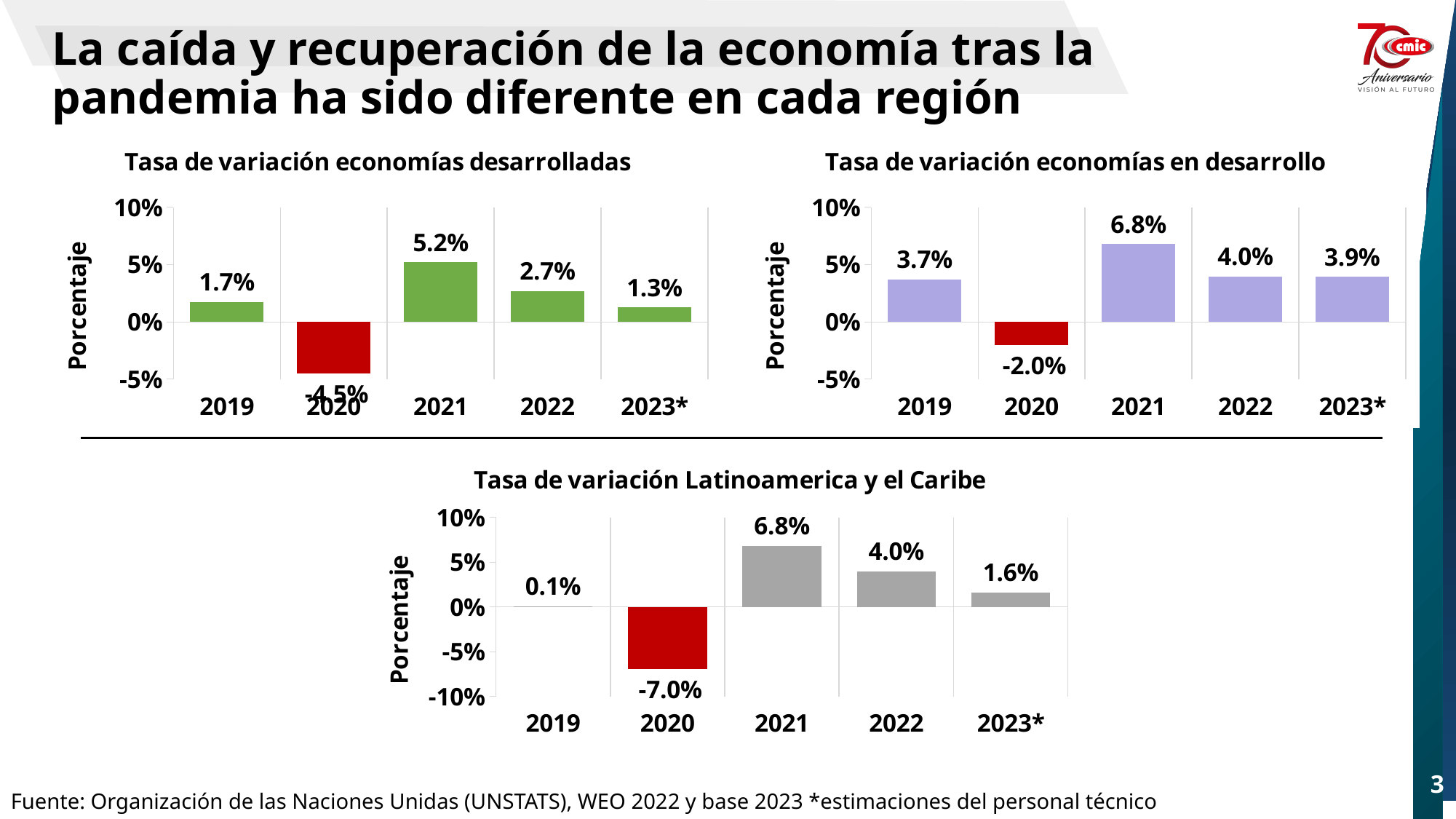
In the chart 'Tasa de variación Latinoamerica y el Caribe', is the value for 2020 greater or less than -5%? less What kind of chart is 'Tasa de variación Latinoamerica y el Caribe'? bar chart In the chart 'Tasa de variación economías en desarrollo', do the values rise or fall from 2021 to 2023*? fall In the chart 'Tasa de variación economías desarrolladas', what is the difference between the values for 2021 and 2022? 2.5% In the chart 'Tasa de variación economías desarrolladas', what is the value for 2021? 5.2% In the chart 'Tasa de variación economías en desarrollo', which year has the highest value? 2021 In the chart 'Tasa de variación Latinoamerica y el Caribe', what is the value for 2023*? 1.6% In the chart 'Tasa de variación Latinoamerica y el Caribe', which year has the lowest value? 2020 In the chart 'Tasa de variación Latinoamerica y el Caribe', what is the difference between the values for 2021 and 2022? 2.8% Which is larger: the 2023* value in 'Tasa de variación economías en desarrollo' or the 2023* value in 'Tasa de variación economías desarrolladas'? Tasa de variación economías en desarrollo In the chart 'Tasa de variación economías en desarrollo', what is the value for 2020? -2.0% How many years are shown on the x axis of the chart 'Tasa de variación economías desarrolladas'? 5